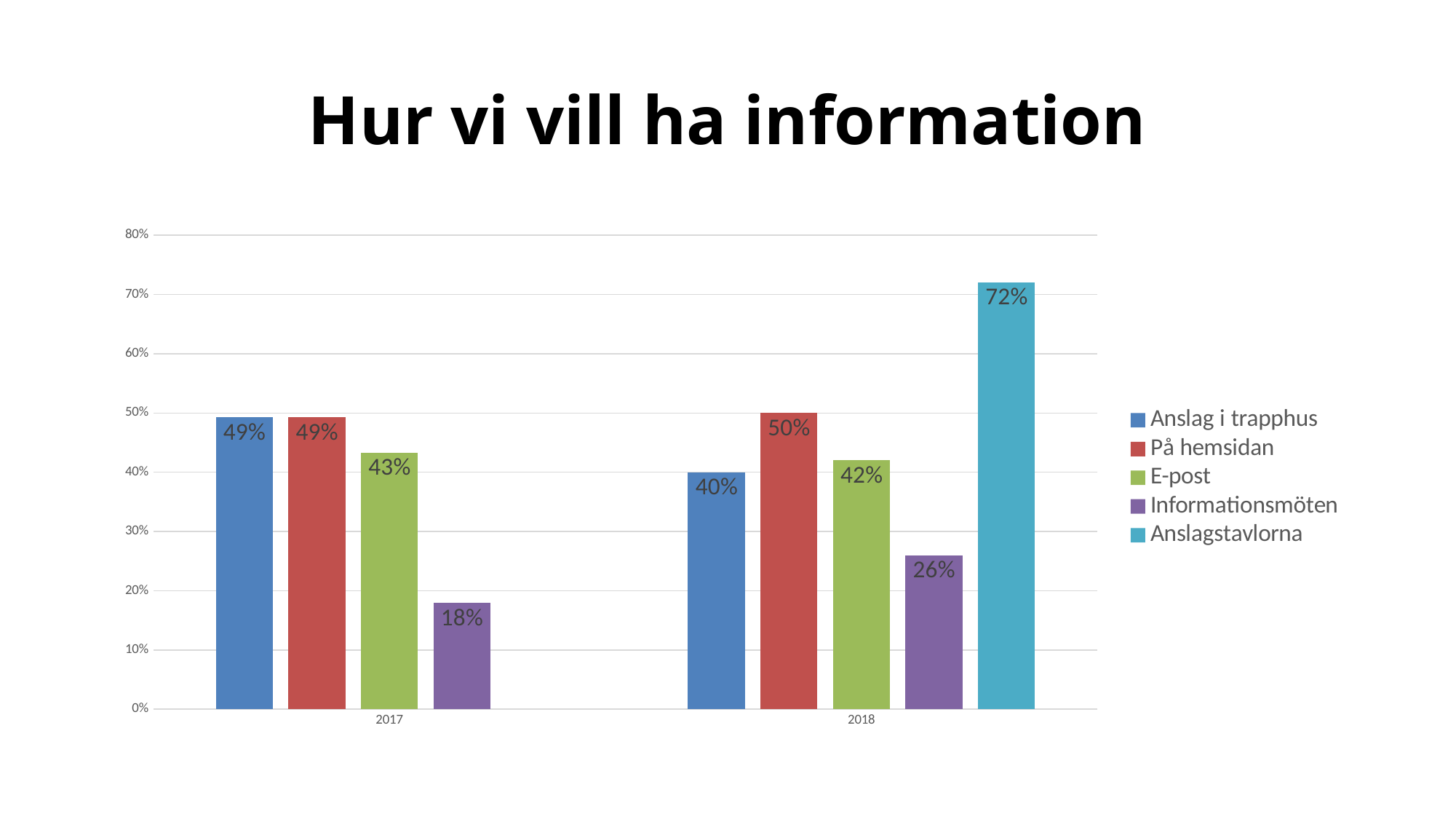
Which series has the lowest value in 2017? Informationsmöten Which is larger, the E-post value in 2017 or in 2018? 2017 What is the title of the slide? Hur vi vill ha information How many series does the legend list? 5 How many year categories are shown on the x axis? 2 What is the value for Informationsmöten in 2017? 18% What is the value for På hemsidan in 2018? 50% What kind of chart is shown on the slide? Bar chart What is the value for Anslagstavlorna in 2018? 72% What is the value for Anslag i trapphus in 2017? 49% What is the difference between the Informationsmöten values for 2018 and 2017? 8% Which series has the highest value in 2018? Anslagstavlorna